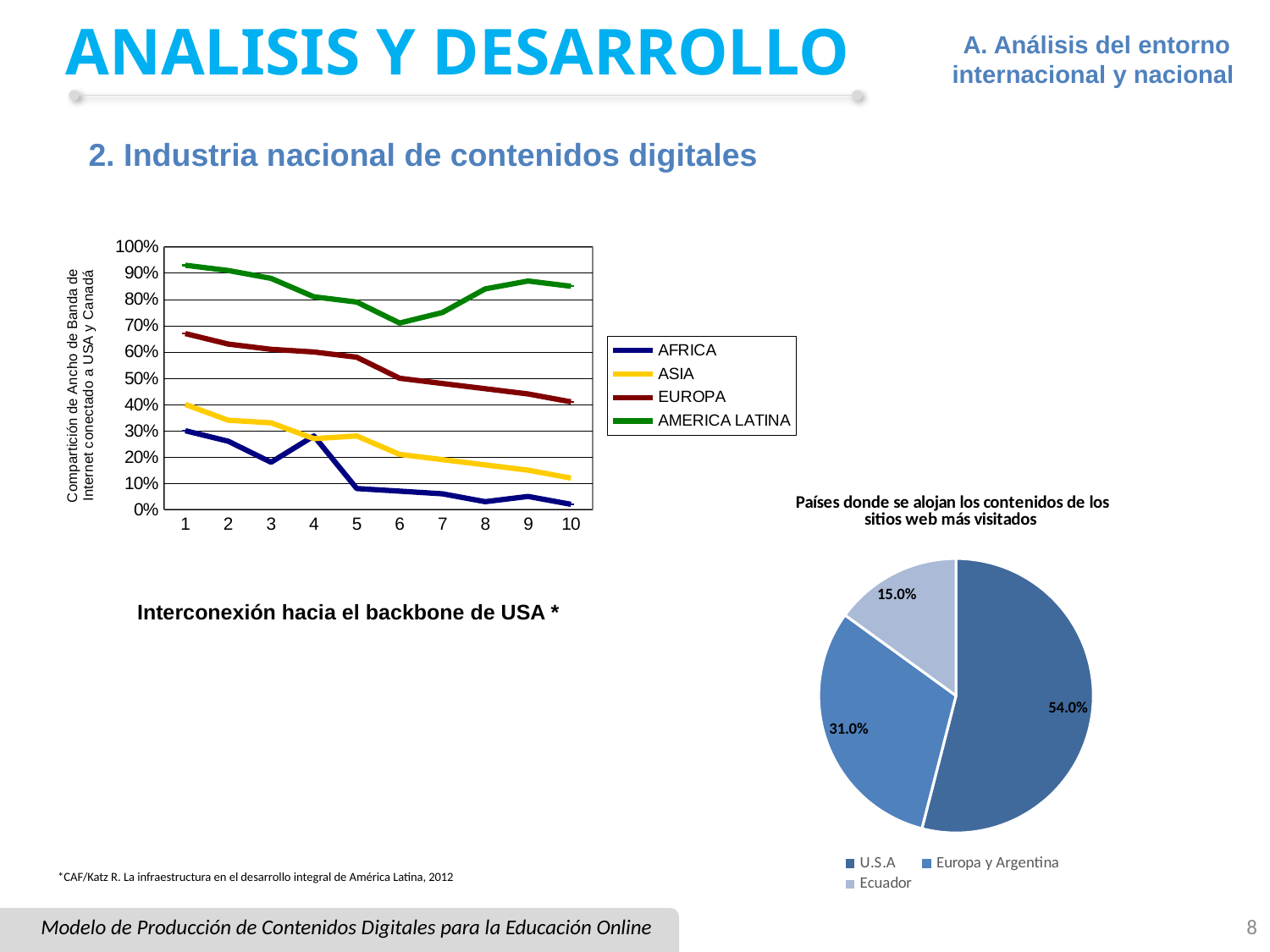
In the line chart 'Interconexión hacia el backbone de USA', is the value for AMERICA LATINA at point 1 greater or less than 90%? greater In the line chart 'Interconexión hacia el backbone de USA', how many points are there along the x axis? 10 In the line chart 'Interconexión hacia el backbone de USA', is the value for AFRICA at point 10 greater or less than 10%? less In the line chart 'Interconexión hacia el backbone de USA', how many series does the legend list? 4 In the pie chart 'Países donde se alojan los contenidos de los sitios web más visitados', which category has the largest slice? U.S.A In the pie chart 'Países donde se alojan los contenidos de los sitios web más visitados', how many slices are there? 3 In the pie chart 'Países donde se alojan los contenidos de los sitios web más visitados', which category has the smallest slice? Ecuador In the pie chart 'Países donde se alojan los contenidos de los sitios web más visitados', what share does Ecuador have? 15.0% What kind of chart is the chart on the right of the slide? Pie chart In the line chart 'Interconexión hacia el backbone de USA', does the EUROPA series rise or fall from point 1 to point 10? Fall In the pie chart 'Países donde se alojan los contenidos de los sitios web más visitados', what is the difference between the U.S.A share and the Europa y Argentina share? 23.0% In the pie chart 'Países donde se alojan los contenidos de los sitios web más visitados', what share does U.S.A have? 54.0%